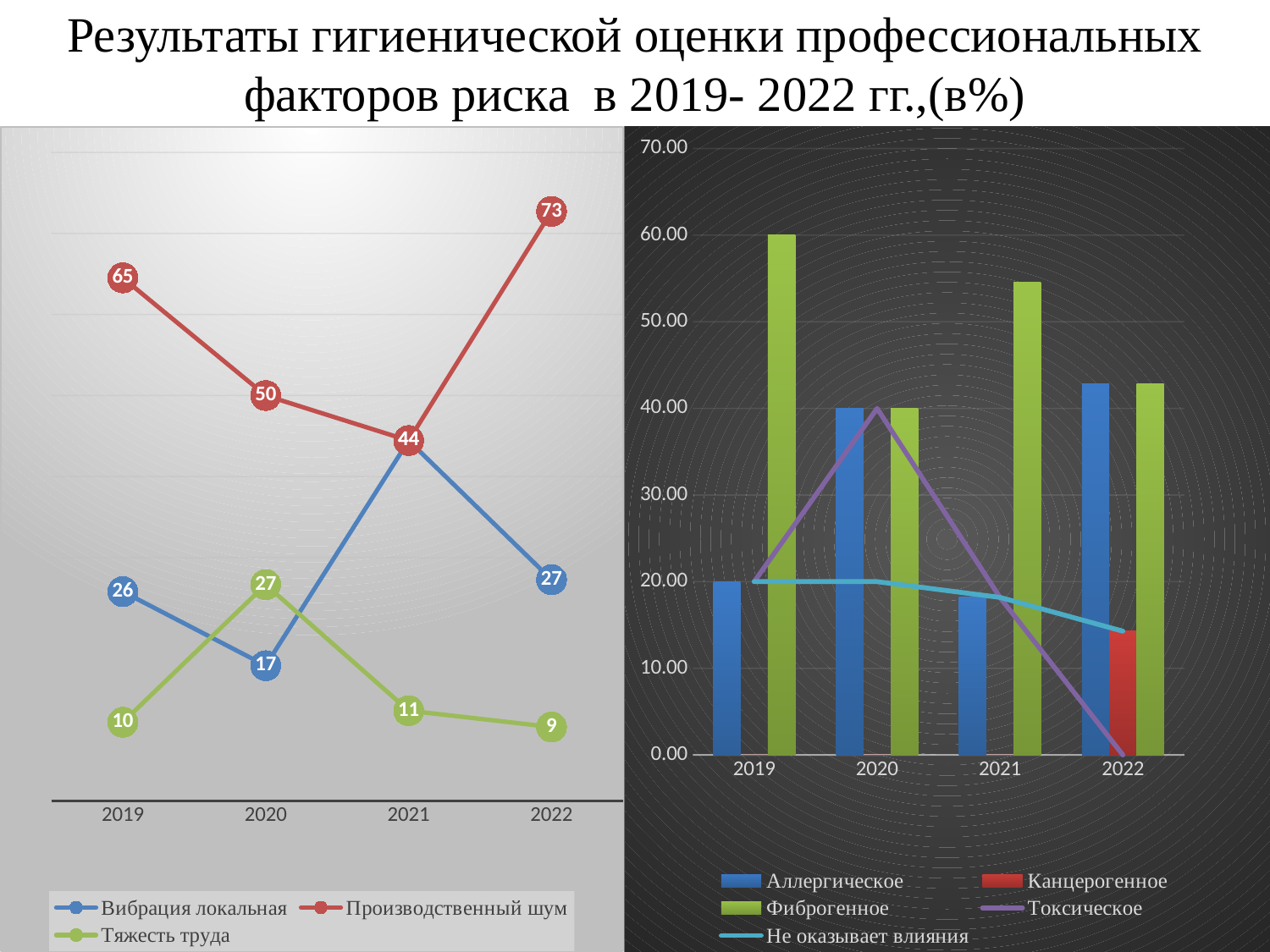
In the left chart, in which year is Вибрация локальная highest? 2021 In the right chart, in which year is the Фиброгенное bar highest? 2019 In the left chart, which is larger in 2020: Вибрация локальная or Тяжесть труда? Тяжесть труда In the left chart, in which year is Производственный шум lowest? 2021 In the left chart, how many years are shown on the x axis? 4 In the right chart, how many series does the legend list? 5 In the left chart, what is the difference between Производственный шум in 2019 and in 2020? 15 In the left chart, what is the value for Тяжесть труда in 2020? 27 In the left chart, what is the value for Производственный шум in 2022? 73 In the right chart, is the value of the Фиброгенное bar for 2019 greater or less than 50.00? greater In the left chart, how many series does the legend list? 3 In the left chart, what is the value for Вибрация локальная in 2021? 44